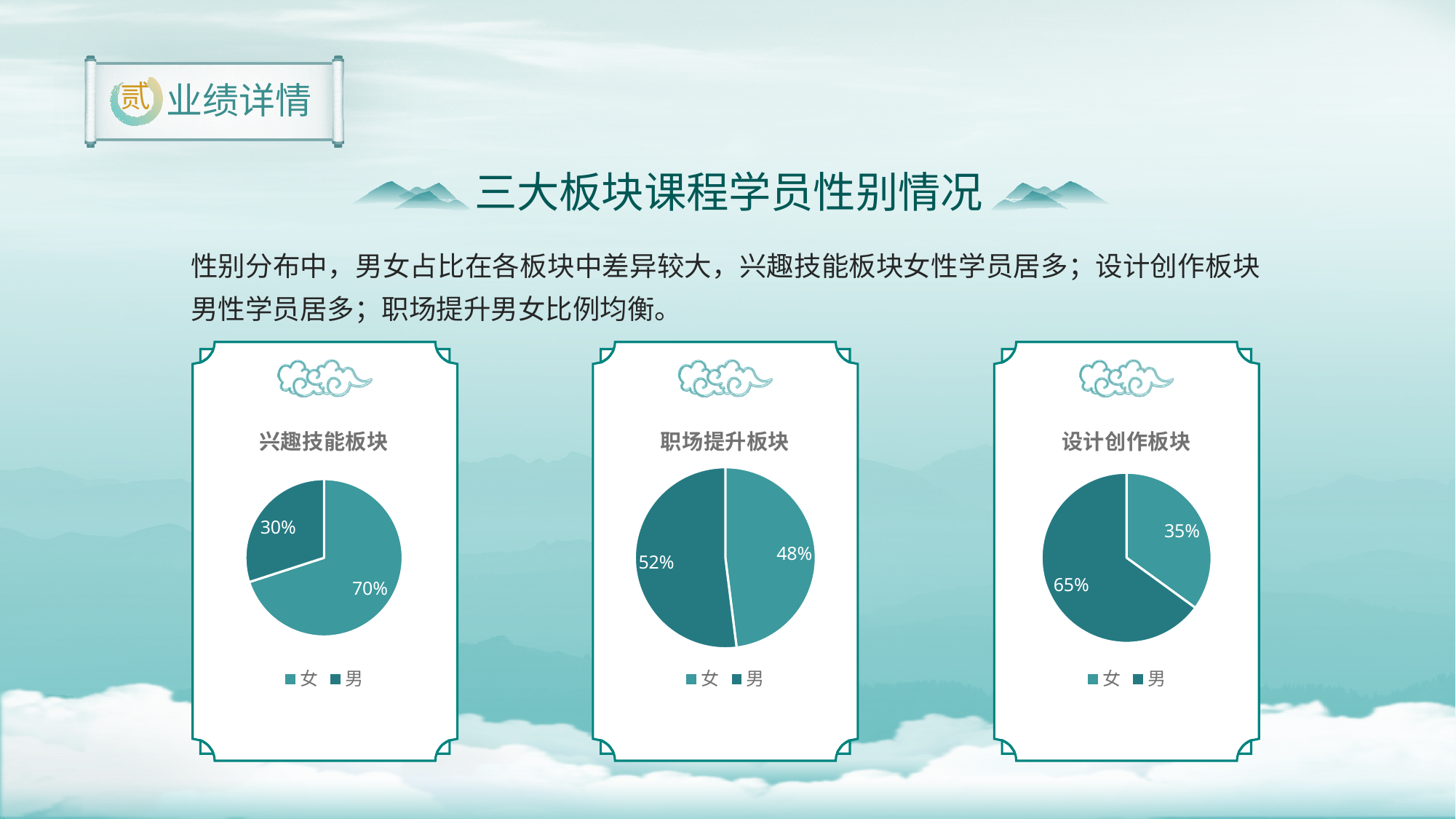
In the 设计创作板块 chart, what share of students are 女? 35% What type of chart is the 职场提升板块 chart? Pie chart In the 兴趣技能板块 chart, what share of students are 男? 30% In the 设计创作板块 chart, which slice is the largest? 男 In the 兴趣技能板块 chart, which slice is larger, 女 or 男? 女 How many entries does the legend of the 职场提升板块 chart list? 2 In the 职场提升板块 chart, what share of students are 女? 48% In the 设计创作板块 chart, what is the difference between the 男 and 女 shares? 30% In the 兴趣技能板块 chart, what share of students are 女? 70% In the 设计创作板块 chart, what share of students are 男? 65% In the 兴趣技能板块 chart, what is the difference between the 女 and 男 shares? 40% In the 职场提升板块 chart, what share of students are 男? 52%